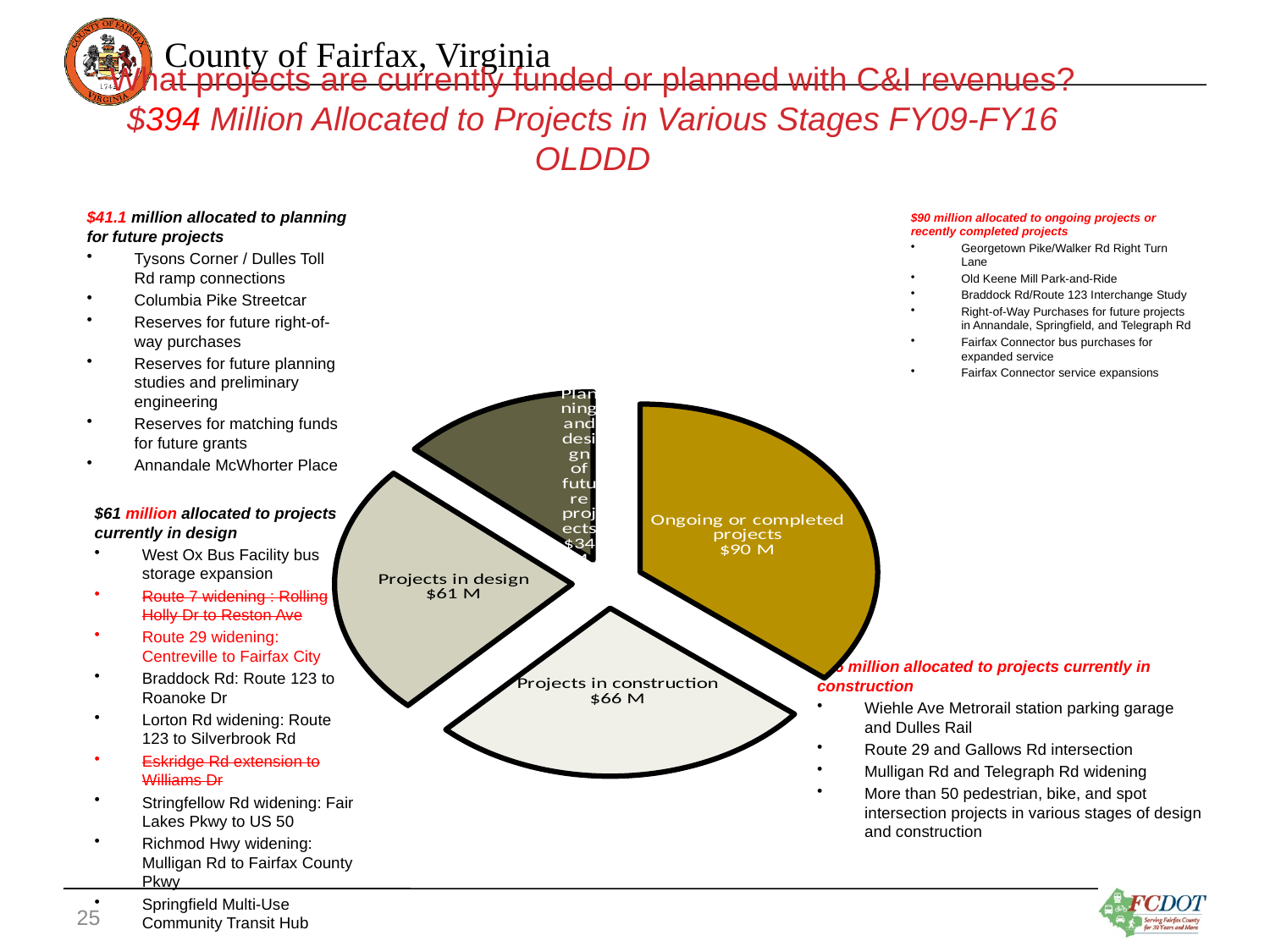
What value is shown for the Projects in construction slice of the pie chart? $66 M What is the difference between the Ongoing or completed projects value and the Projects in construction value? $24 M What is the difference between the Ongoing or completed projects value and the Projects in design value? $29 M What kind of chart is shown on the slide? Pie chart Which is larger, Projects in construction or Projects in design? Projects in construction Which slice of the pie chart has the largest value? Ongoing or completed projects What value is shown for the Ongoing or completed projects slice of the pie chart? $90 M What is the difference between the Projects in construction value and the Projects in design value? $5 M How many slices does the pie chart have? 4 Which slice of the pie chart is the smallest? Planning and design of future projects What value is shown for the Projects in design slice of the pie chart? $61 M What colour is the Ongoing or completed projects slice of the pie chart? Gold